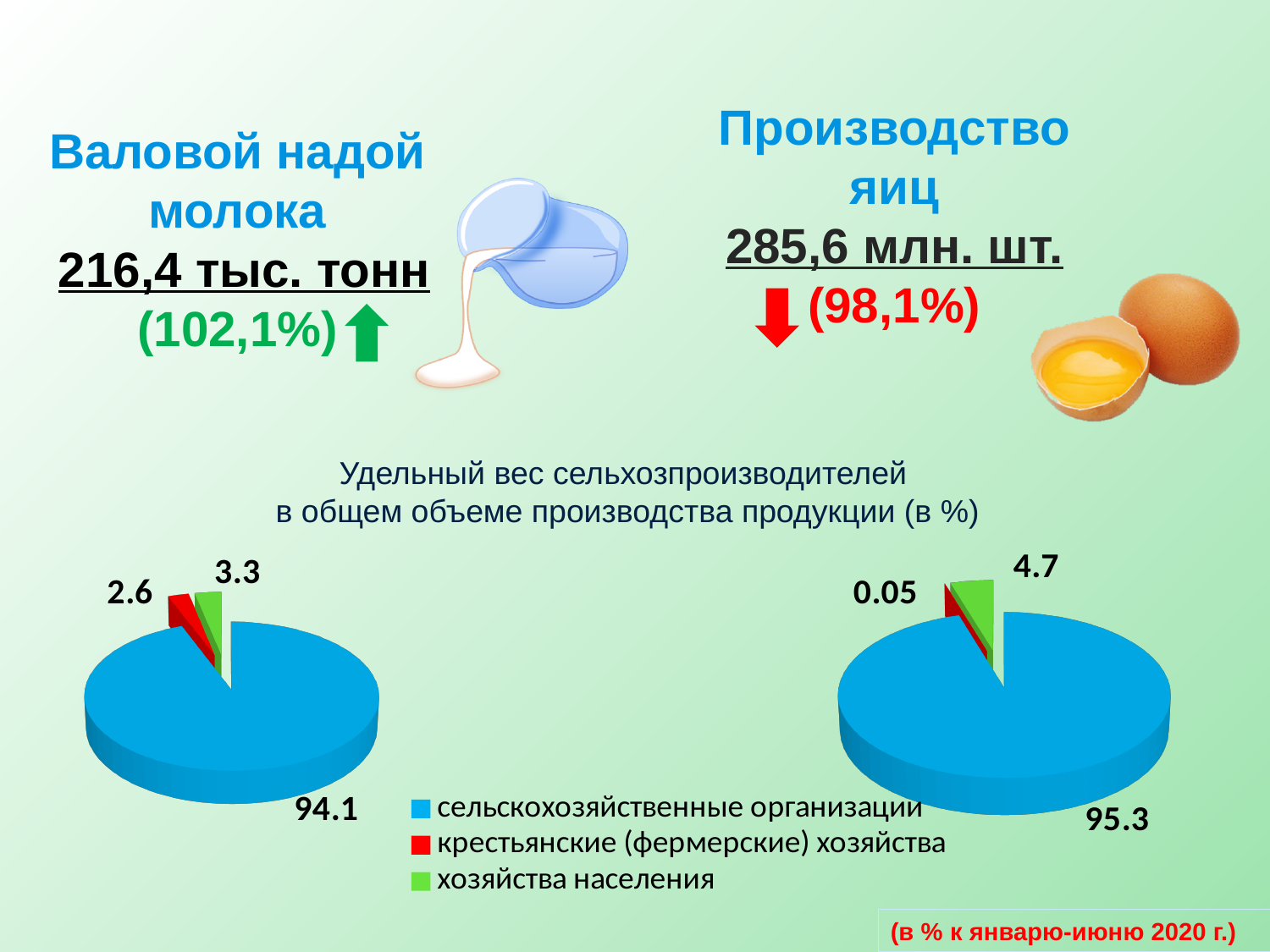
Which is larger: the value for сельскохозяйственные организации in the left pie chart or in the right pie chart? right pie chart What kind of chart is the left chart on the slide? pie chart In the left pie chart, what is the value for сельскохозяйственные организации? 94.1 In the right pie chart, what is the value for хозяйства населения? 4.7 In the right pie chart, what is the value for крестьянские (фермерские) хозяйства? 0.05 In the right pie chart, what is the difference between the values for сельскохозяйственные организации and хозяйства населения? 90.6 How many slices does the left pie chart have? 3 In the right pie chart, which category has the largest share? сельскохозяйственные организации How many entries does the shared legend list? 3 In the left pie chart, what is the difference between the values for хозяйства населения and крестьянские (фермерские) хозяйства? 0.7 In the left pie chart, which category has the smallest share? крестьянские (фермерские) хозяйства In the left pie chart, what is the value for крестьянские (фермерские) хозяйства? 2.6